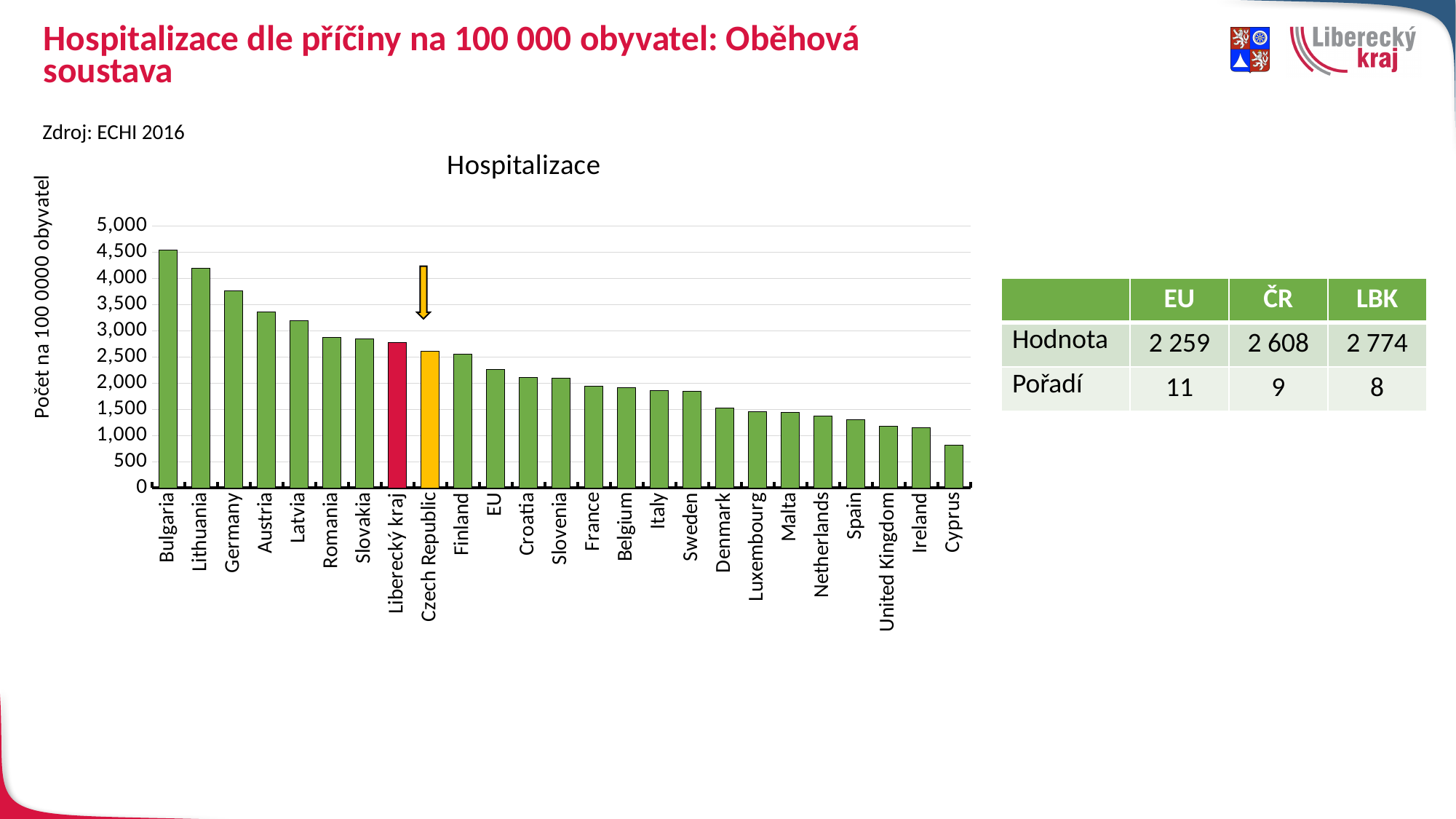
Is the value for Germany greater or less than 3,500? greater According to the table on the slide, what is the value (Hodnota) for LBK? 2 774 Do the values rise or fall from left to right along the x axis? fall Which category has the lowest value in the chart? Cyprus Is the value for Cyprus greater or less than 1,000? less Which category has the highest value in the chart? Bulgaria Is the value for Bulgaria greater or less than 4,000? greater What kind of chart is shown on the slide? bar chart How many categories (bars) are shown in the chart? 25 What is the title of the chart? Hospitalizace According to the table on the slide, what is the difference between the value for LBK and the value for EU? 515 Which is larger, the value for Germany or the value for Austria? Germany